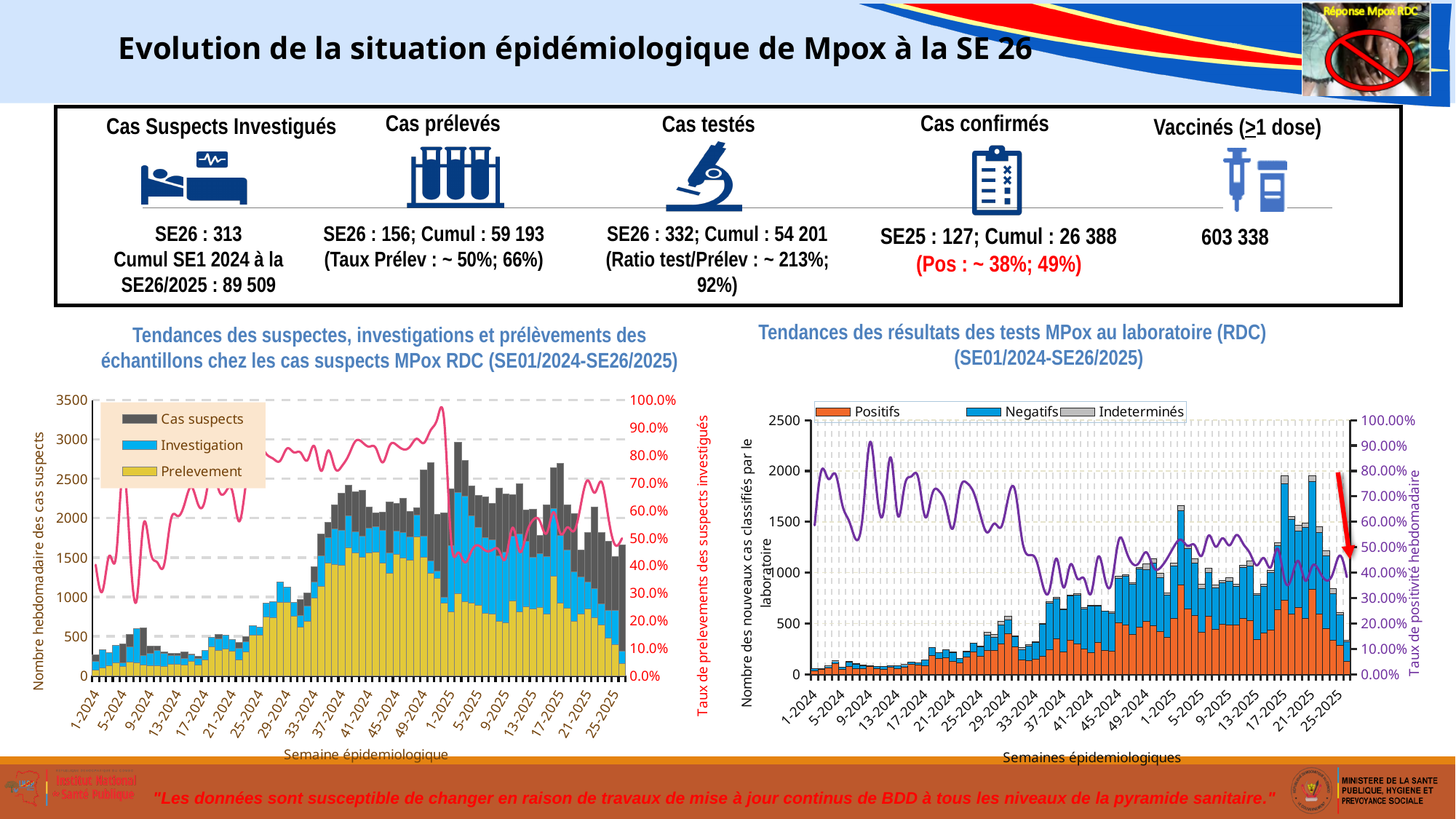
What is the x-axis label of the left chart (Tendances des suspectes, investigations et prélèvements)? Semaine épidemiologique What kind of chart is the left chart titled 'Tendances des suspectes, investigations et prélèvements des échantillons chez les cas suspects MPox RDC'? Bar chart with a line In the right chart (Tendances des résultats des tests MPox au laboratoire), is the total bar height at week 17-2025 greater or less than 1500? greater In the left chart (Tendances des suspectes, investigations et prélèvements), which series is shown in yellow? Prelevement In the right chart (Tendances des résultats des tests MPox au laboratoire), is the total bar height at week 1-2024 greater or less than 500? less In the right chart (Tendances des résultats des tests MPox au laboratoire), does the positivity rate line (Taux de positivité hebdomadaire) overall rise or fall from 1-2024 to 25-2025? fall In the right chart (Tendances des résultats des tests MPox au laboratoire), is the Positifs value at week 21-2025 greater or less than 500? greater How many series does the legend of the left chart (Tendances des suspectes, investigations et prélèvements) list? 3 What kind of chart is the right chart titled 'Tendances des résultats des tests MPox au laboratoire (RDC)'? Stacked bar chart with a line How many series does the legend of the right chart (Tendances des résultats des tests MPox au laboratoire) list? 3